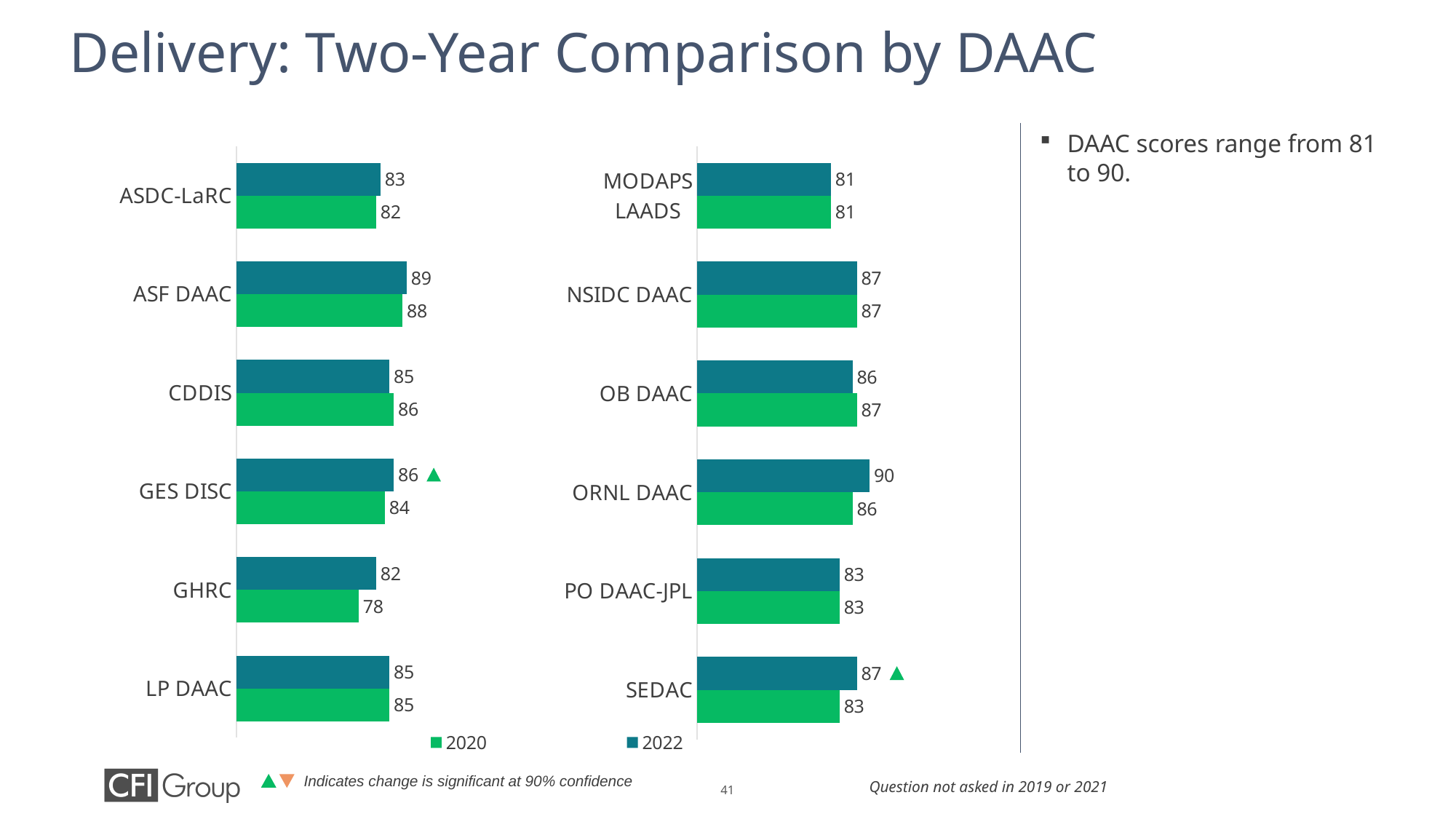
In the right chart, what is the 2020 value for ORNL DAAC? 86 In the left chart, which DAAC has the lowest 2020 value? GHRC How many series does the legend list? 2 In the left chart, what is the difference between the 2022 and 2020 values for GHRC? 4 In the right chart, what is the difference between the 2022 and 2020 values for SEDAC? 4 In the left chart, is the 2020 value for CDDIS larger or smaller than its 2022 value? larger Which colour represents the 2020 series in the legend? green In the left chart, what is the 2022 value for GHRC? 82 How many DAACs are shown in the right chart? 6 What type of chart is used on this slide? bar chart In the right chart, which DAAC has the highest 2022 value? ORNL DAAC In the left chart, what is the 2020 value for GES DISC? 84